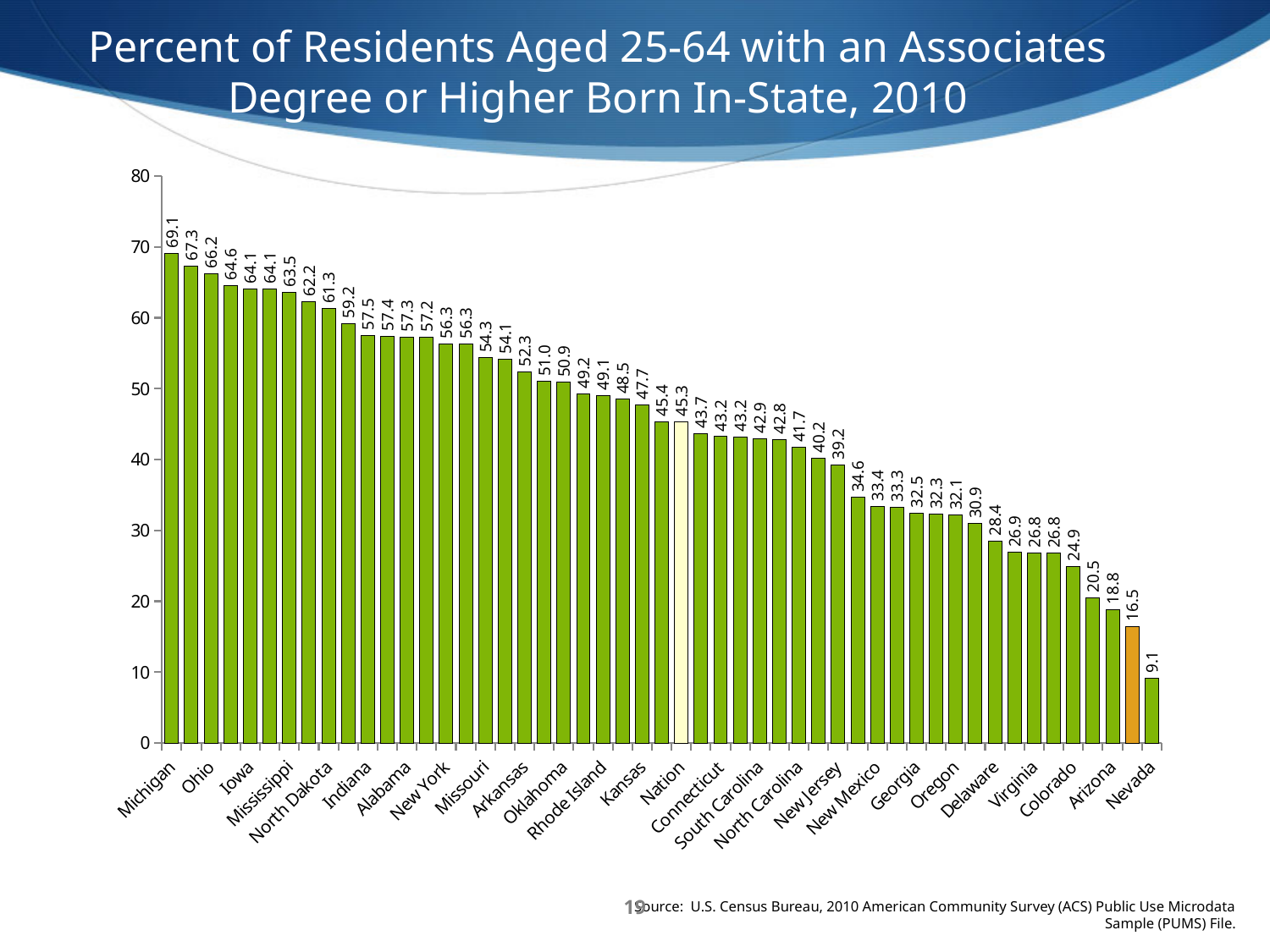
What kind of chart is shown on the slide? bar chart Do the values rise or fall moving from left to right along the x axis? fall Is the value for Indiana greater or less than 50? greater Which category has the lowest value? Nevada Which category has the highest value? Michigan What is the difference between the values for Michigan and Nevada? 60.0 Which is larger, the value for Ohio or the value for Georgia? Ohio What is the value for Nevada? 9.1 Is the value for Arizona greater or less than 20? less What value is shown on the orange bar? 16.5 What is the value for the Nation bar? 45.3 What is the value for Michigan? 69.1